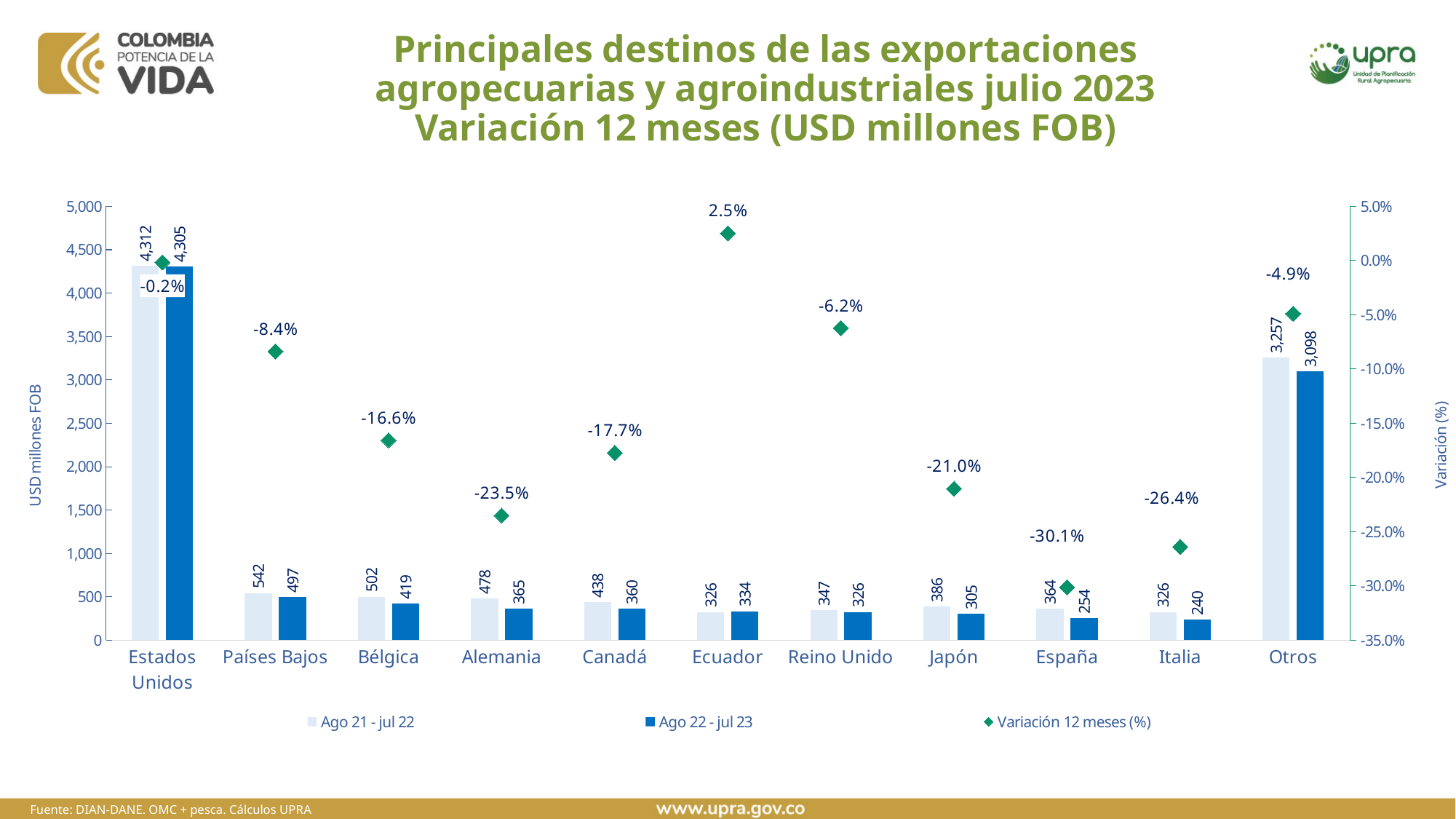
What is the label of the left vertical axis? USD millones FOB Which destination has the highest Variación 12 meses (%)? Ecuador What is the value for Estados Unidos in the Ago 22 - jul 23 series? 4,305 How many destination categories are shown on the x axis? 11 How many series does the legend list? 3 What is the difference between the Ago 21 - jul 22 and Ago 22 - jul 23 values for Bélgica? 83 What kind of chart is used for the Ago 21 - jul 22 and Ago 22 - jul 23 series? Bar chart Which is larger for Ecuador: the Ago 21 - jul 22 value or the Ago 22 - jul 23 value? Ago 22 - jul 23 What is the value for Alemania in the Ago 21 - jul 22 series? 478 Excluding Otros, which country has the lowest value in the Ago 22 - jul 23 series? Italia Is the Ago 22 - jul 23 value for Otros greater or less than 3,000? greater What is the Variación 12 meses (%) value for España? -30.1%